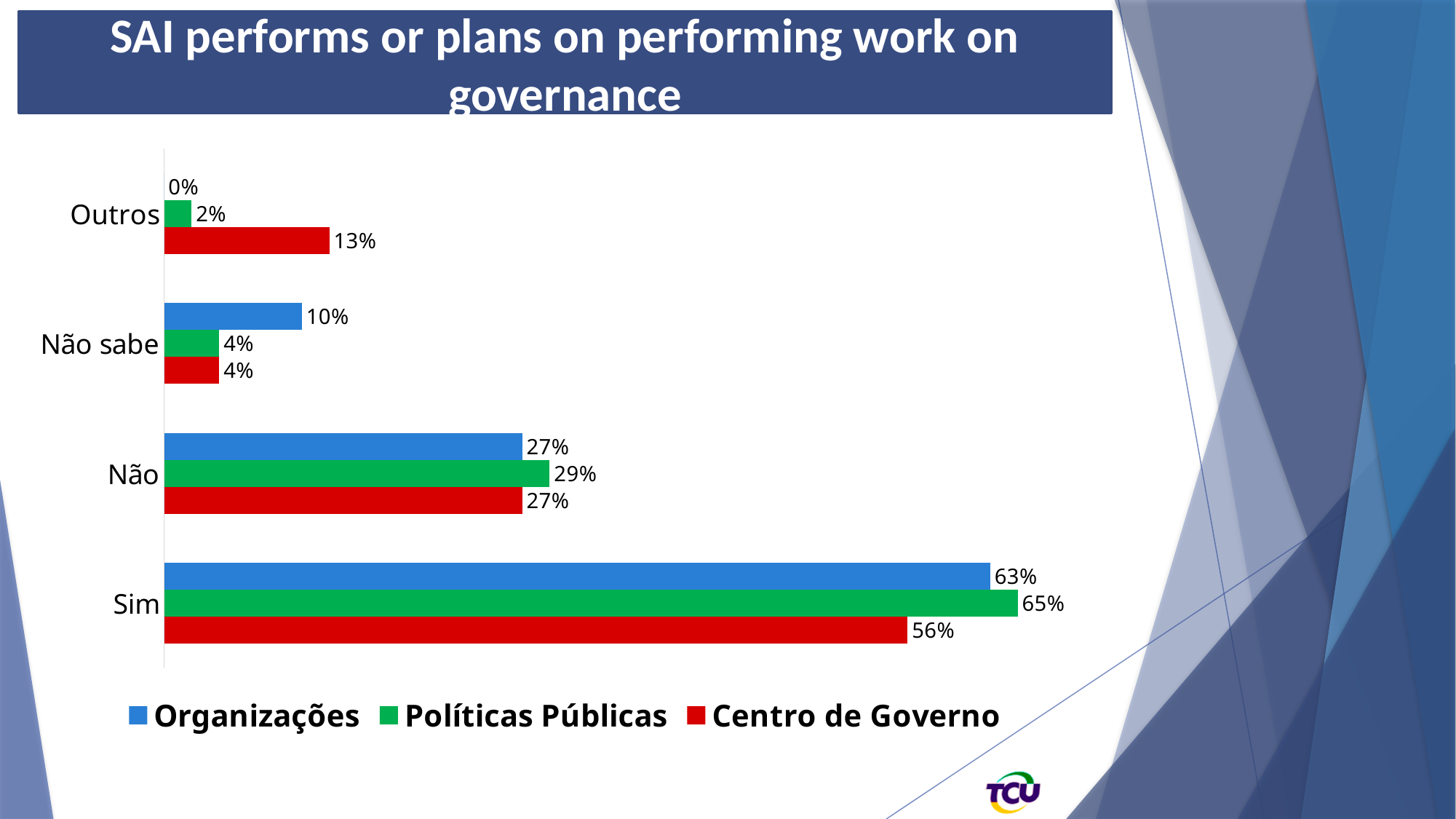
In the Outros category, which is larger: Políticas Públicas or Centro de Governo? Centro de Governo Which category has the highest value for Centro de Governo? Sim What kind of chart is shown on the slide? Bar chart How many categories are shown on the chart? 4 What is the value for Organizações in the Não sabe category? 10% Which category has the lowest value for Organizações? Outros What is the value for Políticas Públicas in the Não category? 29% How many series does the legend list? 3 What colour represents the Centro de Governo series? Red What is the value for Organizações in the Sim category? 63% What is the difference between Políticas Públicas and Centro de Governo in the Sim category? 9% What is the value for Centro de Governo in the Outros category? 13%